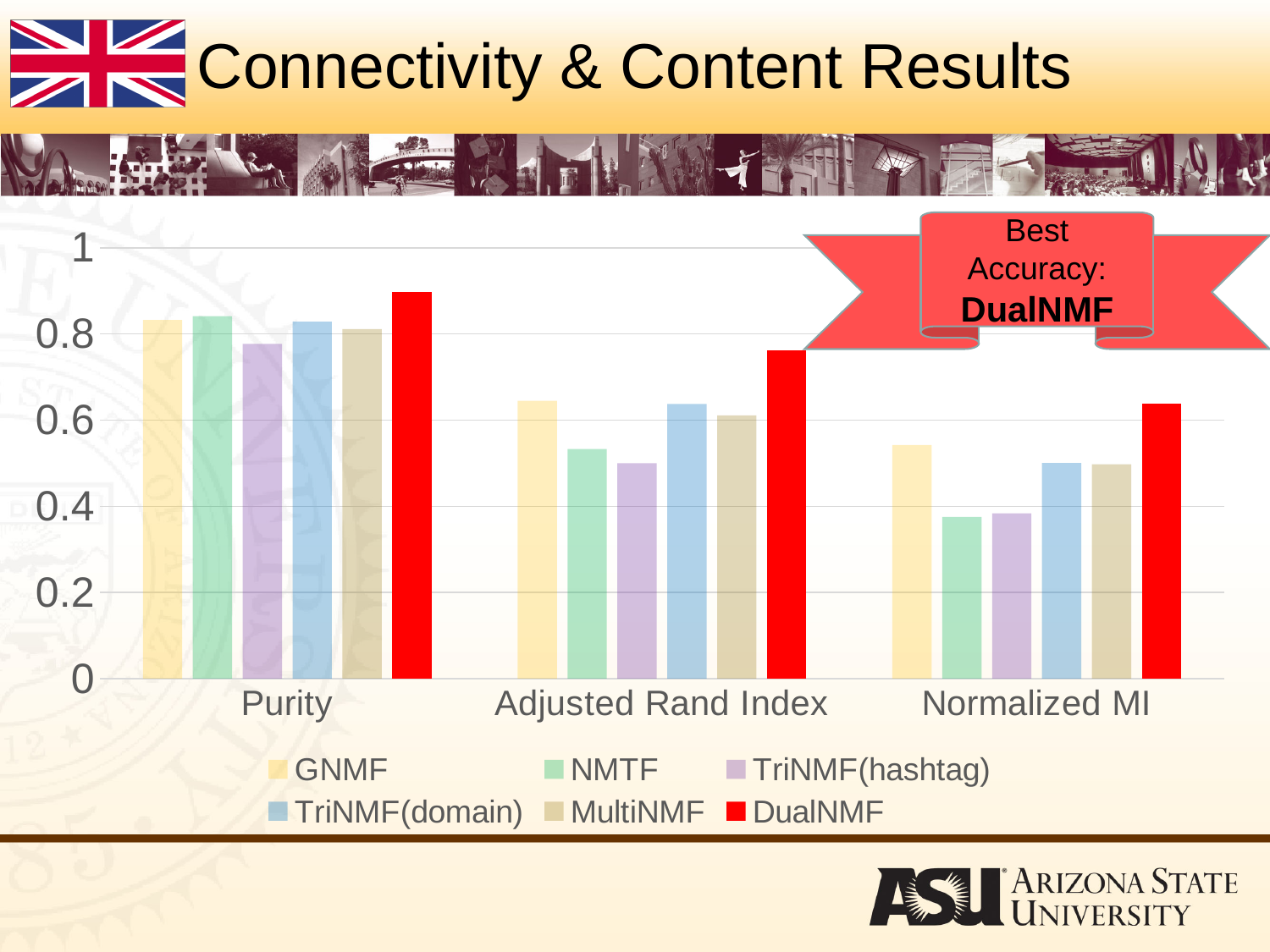
Is the GNMF value for Adjusted Rand Index greater or less than 0.6? greater How many categories are shown on the x axis of the chart? 3 Is the NMTF value for Normalized MI greater or less than 0.4? less Is the DualNMF value for Adjusted Rand Index greater or less than 0.8? less Which method has the highest bar for Normalized MI? DualNMF How many series does the chart's legend list? 6 What kind of chart is shown on the slide? bar chart Which colour represents DualNMF in the chart's legend? red Which method has the highest bar for Adjusted Rand Index? DualNMF Which method has the highest bar for Purity? DualNMF Which is larger for DualNMF: the Adjusted Rand Index value or the Normalized MI value? Adjusted Rand Index